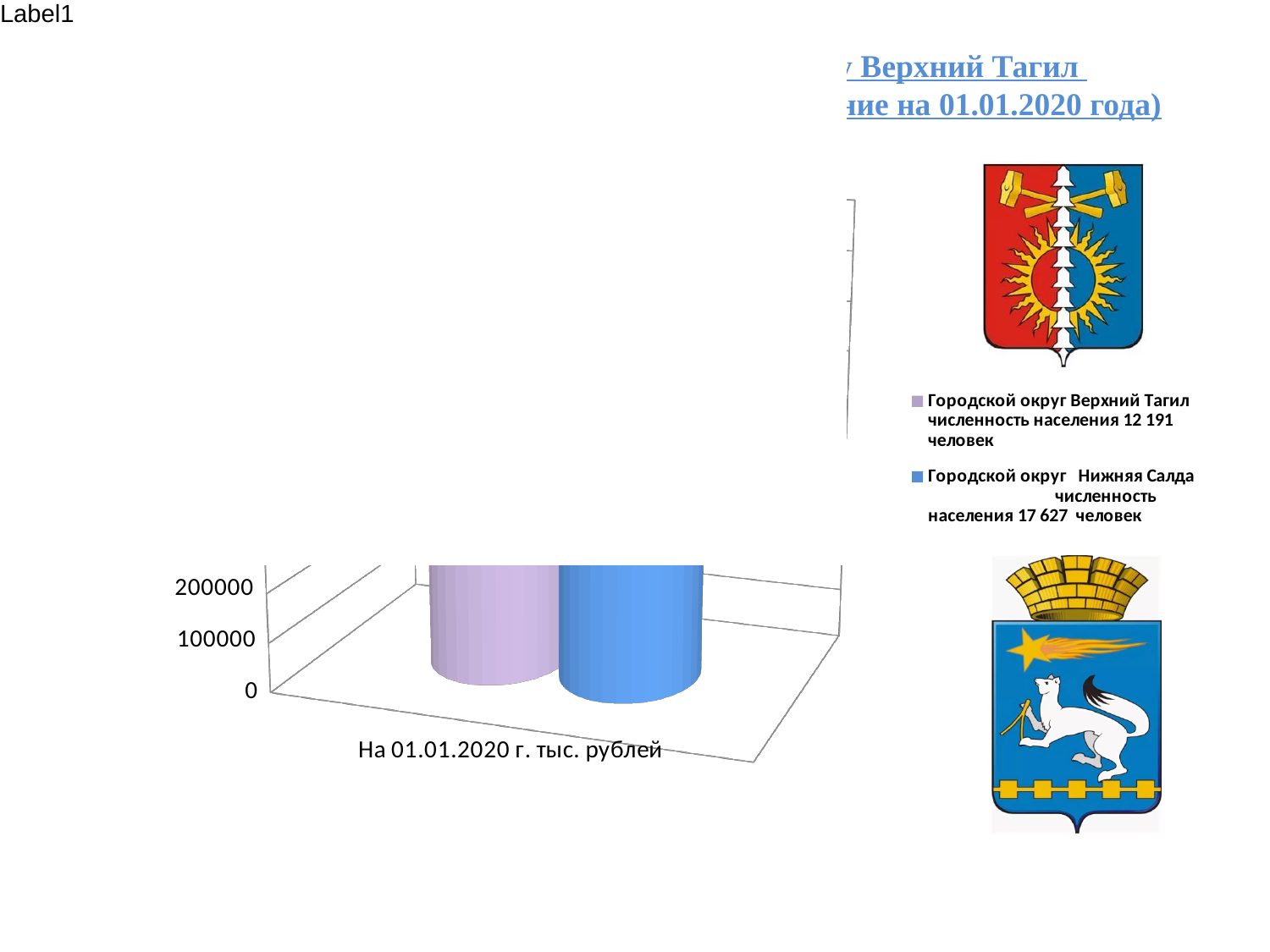
Is the value for Городской округ Нижняя Салда greater or less than 100000? greater Is the value for Городской округ Нижняя Салда greater or less than 200000? greater What is the category label shown on the x axis of the chart? На 01.01.2020 г. тыс. рублей What kind of chart is shown on the slide? bar chart Which colour represents Городской округ Нижняя Салда in the chart legend? blue How many series does the chart legend list? 2 Is the value for Городской округ Верхний Тагил greater or less than 200000? greater How many categories are shown on the x axis of the chart? 1 What is the highest value labelled on the vertical axis of the chart? 200000